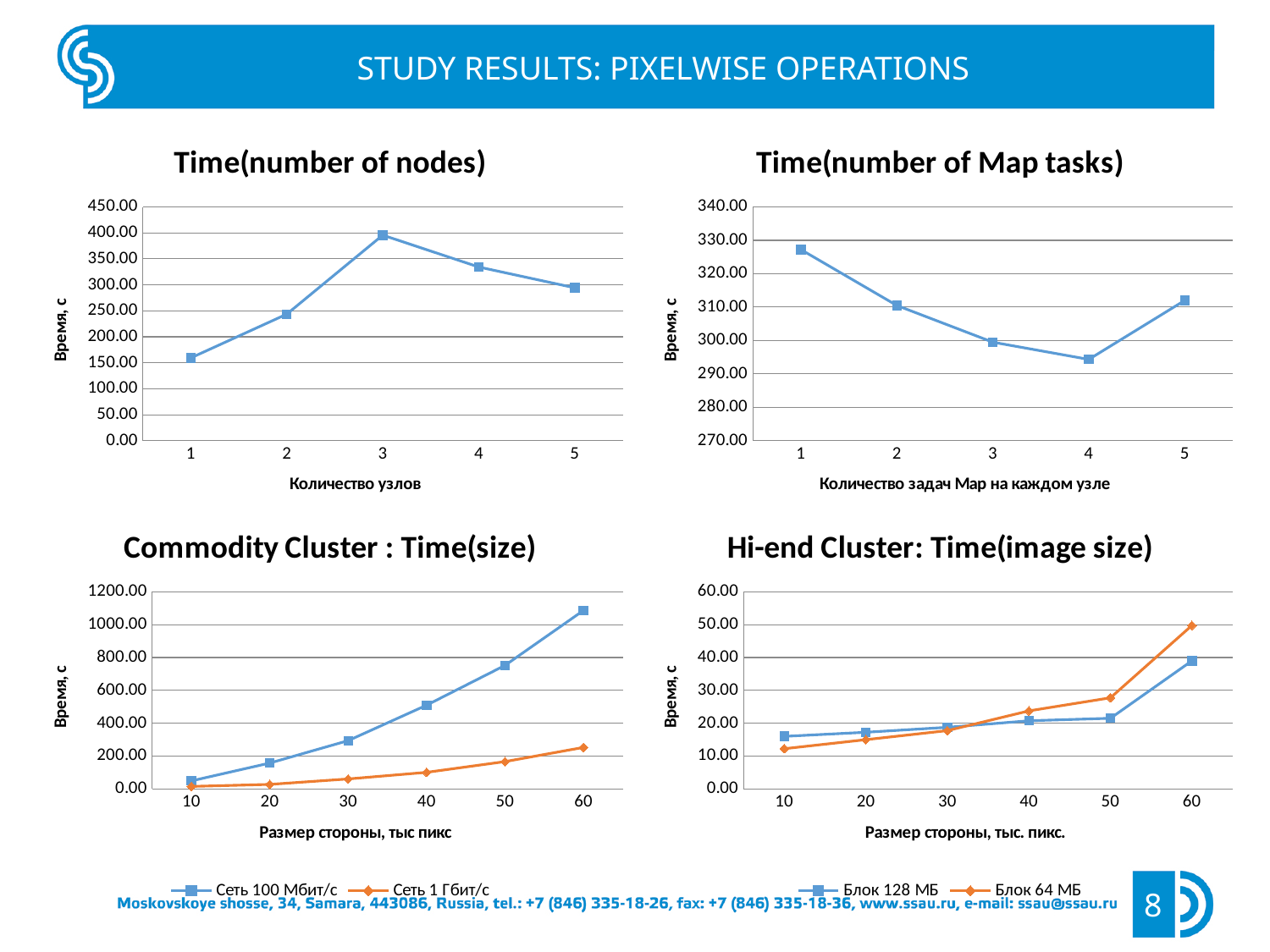
In the Time(number of nodes) chart, how many data points are plotted? 5 In the Commodity Cluster : Time(size) chart, is the value for Сеть 100 Мбит/с at size 60 greater or less than 1000.00? greater In the Time(number of Map tasks) chart, which number of Map tasks has the lowest time? 4 In the Commodity Cluster : Time(size) chart, which series is larger at size 60, Сеть 100 Мбит/с or Сеть 1 Гбит/с? Сеть 100 Мбит/с In the Time(number of nodes) chart, which number of nodes has the lowest time? 1 In the Time(number of Map tasks) chart, which number of Map tasks has the highest time? 1 In the Time(number of Map tasks) chart, is the value for 1 Map task greater or less than 320.00? greater In the Time(number of nodes) chart, is the value for 3 nodes greater or less than 350.00? greater How many series does the legend of the Hi-end Cluster: Time(image size) chart list? 2 In the Hi-end Cluster: Time(image size) chart, which series is larger at size 60, Блок 128 МБ or Блок 64 МБ? Блок 64 МБ In the Time(number of nodes) chart, which number of nodes has the highest time? 3 What kind of chart is the Commodity Cluster : Time(size) chart? Line chart